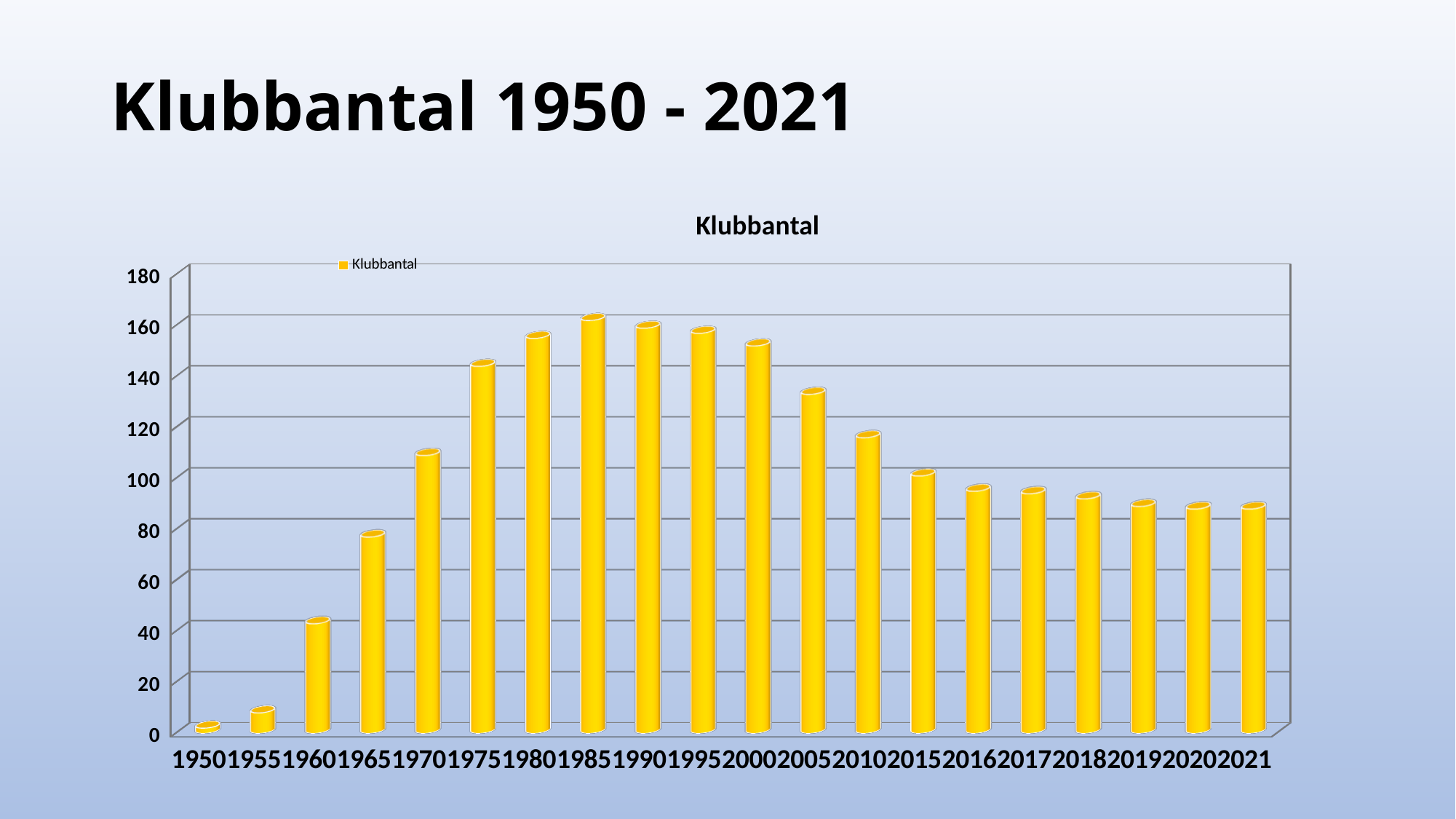
Is the value for 2021 greater or less than 100? less Is the value for 1980 greater or less than 140? greater How many series does the legend of the chart list? 1 What is the title of the chart? Klubbantal Is the value for 2005 greater or less than 120? greater Which is larger, the value for 1965 or the value for 2010? 2010 Which year has the highest value in the chart? 1985 Do the values rise or fall from 1985 to 2021? fall What kind of chart is shown on the slide? bar chart Which year has the lowest value in the chart? 1950 How many years (categories) are shown on the x axis of the chart? 20